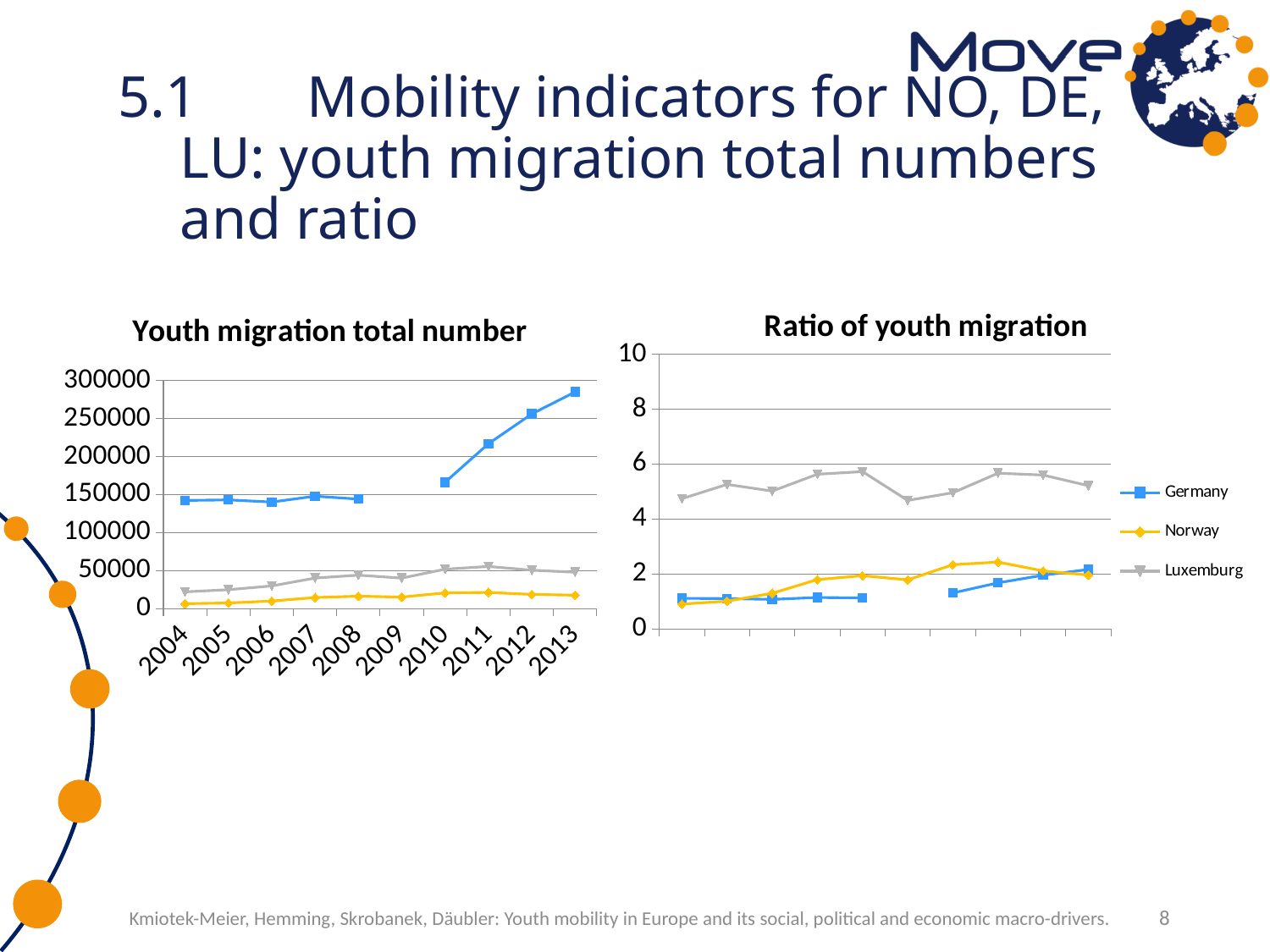
In the "Youth migration total number" chart, does the Germany line rise or fall from 2010 to 2013? rise In the "Youth migration total number" chart, which country has the lowest value in 2004? Norway In the "Ratio of youth migration" chart, which country has the highest ratio across the whole period? Luxemburg How many years are labelled on the x axis of the "Youth migration total number" chart? 10 In the "Youth migration total number" chart, is the value for Germany in 2013 greater or less than 250000? greater What kind of chart is the "Youth migration total number" chart? line chart What kind of chart is the "Ratio of youth migration" chart? line chart In the "Youth migration total number" chart, which country has the highest value in 2013? Germany How many series does the legend on the "Ratio of youth migration" chart list? 3 In the "Ratio of youth migration" chart, is the first value for Luxemburg greater or less than 4? greater In the "Youth migration total number" chart, which is larger in 2012: Luxemburg or Norway? Luxemburg In the "Youth migration total number" chart, is the value for Germany in 2004 greater or less than 150000? less